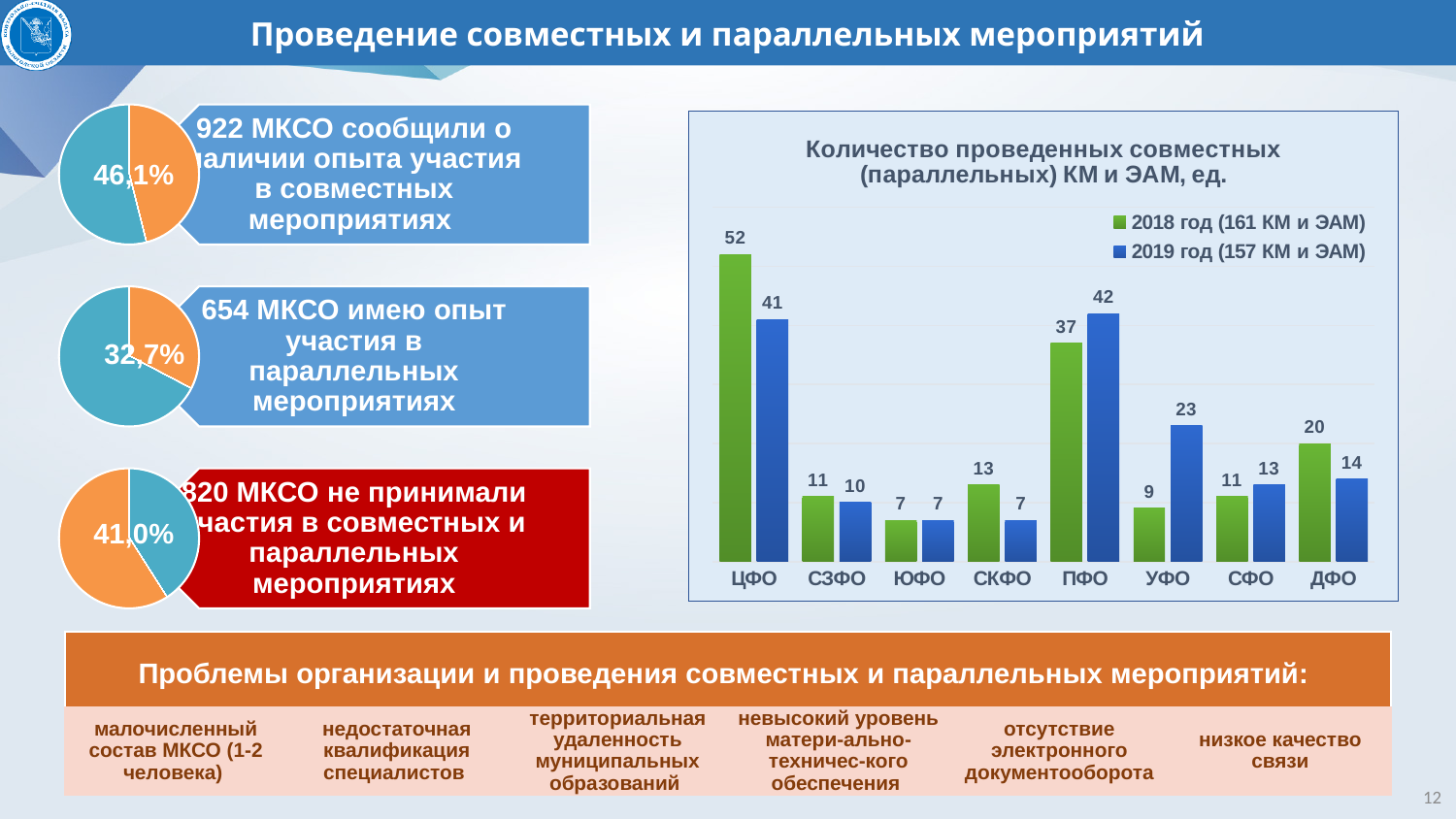
In the bar chart 'Количество проведенных совместных (параллельных) КМ и ЭАМ, ед.', how many series does the legend list? 2 In the bar chart 'Количество проведенных совместных (параллельных) КМ и ЭАМ, ед.', what is the total of the 2018 and 2019 values for СКФО? 20 In the bar chart 'Количество проведенных совместных (параллельных) КМ и ЭАМ, ед.', what is the value for УФО in the 2019 год series? 23 In the bar chart 'Количество проведенных совместных (параллельных) КМ и ЭАМ, ед.', what is the value for ПФО in the 2018 год series? 37 In the bar chart 'Количество проведенных совместных (параллельных) КМ и ЭАМ, ед.', how many categories are shown on the x axis? 8 What percentage is shown on the top pie chart on the left side of the slide, next to the text '922 МКСО сообщили о наличии опыта участия в совместных мероприятиях'? 46,1% What kind of chart is the chart titled 'Количество проведенных совместных (параллельных) КМ и ЭАМ, ед.'? bar chart In the bar chart 'Количество проведенных совместных (параллельных) КМ и ЭАМ, ед.', what is the difference between the 2018 and 2019 values for ЦФО? 11 In the bar chart 'Количество проведенных совместных (параллельных) КМ и ЭАМ, ед.', which category has the lowest value in the 2018 год series? ЮФО In the bar chart 'Количество проведенных совместных (параллельных) КМ и ЭАМ, ед.', which is larger for ДФО: the 2018 год value or the 2019 год value? 2018 год In the bar chart 'Количество проведенных совместных (параллельных) КМ и ЭАМ, ед.', what is the value for ЦФО in the 2018 год series? 52 In the bar chart 'Количество проведенных совместных (параллельных) КМ и ЭАМ, ед.', which category has the highest value in the 2019 год series? ПФО